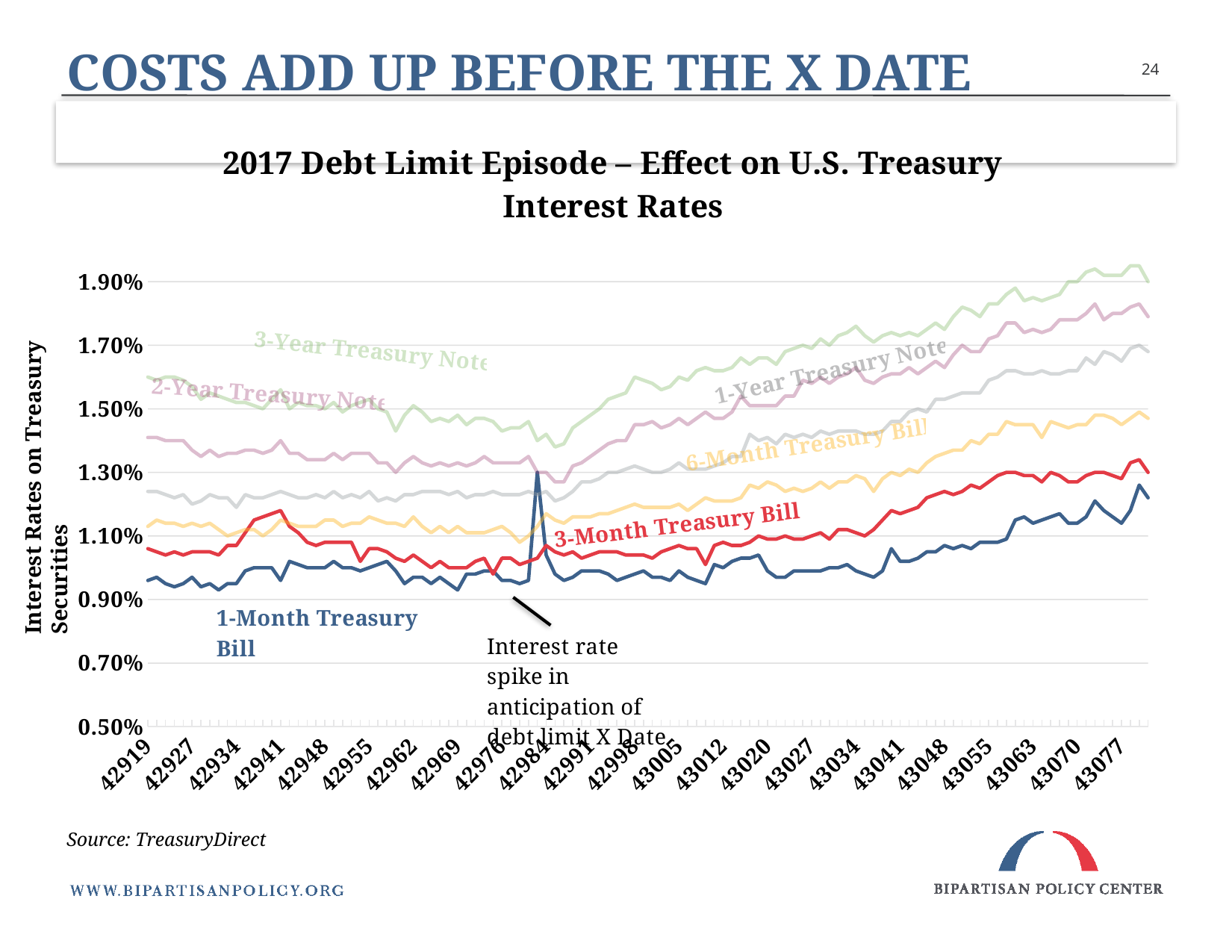
Does the 3-Year Treasury Note rate generally rise or fall from the left to the right of the chart? Rise At the right end of the chart, which is higher: the 3-Month Treasury Bill or the 6-Month Treasury Bill? 6-Month Treasury Bill Which series has the lowest interest rate at the right end of the chart? 1-Month Treasury Bill What is the title of the chart? 2017 Debt Limit Episode – Effect on U.S. Treasury Interest Rates Is the 2-Year Treasury Note rate at the right end of the chart greater or less than 1.70%? greater Which series has the highest interest rate at the right end of the chart? 3-Year Treasury Note What kind of chart is shown on the slide? Line chart Is the 3-Year Treasury Note rate at the start of the chart (42919) greater or less than 1.50%? greater Is the 1-Month Treasury Bill rate at the start of the chart (42919) greater or less than 1.10%? less How many Treasury securities series are plotted on the chart? 6 What is the highest value shown on the y-axis of the chart? 1.90% Which series shows the sharp interest rate spike annotated on the chart? 1-Month Treasury Bill